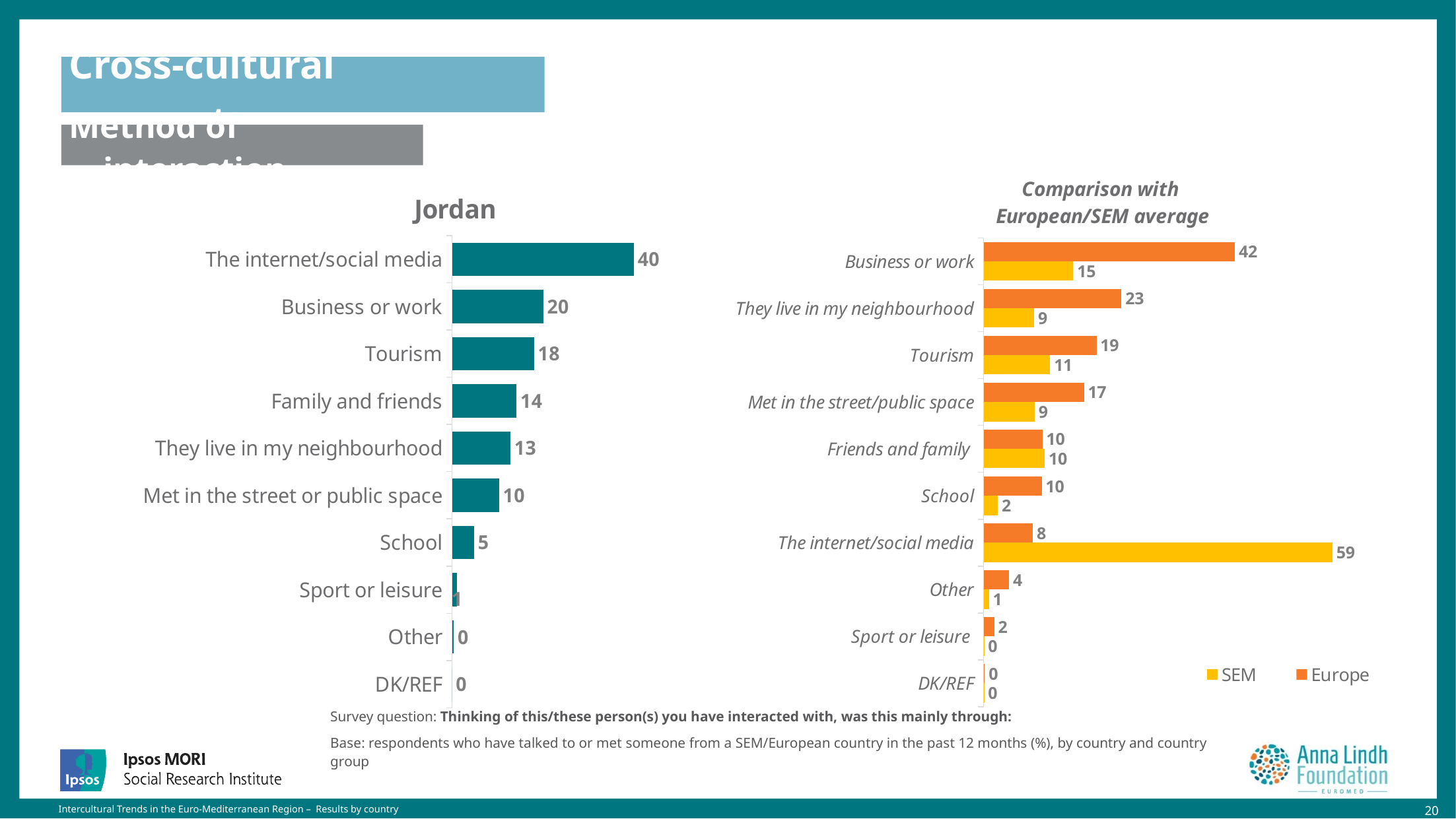
In the Comparison with European/SEM average chart, what is the SEM value for The internet/social media? 59 In the Comparison with European/SEM average chart, which colour represents SEM? Yellow In the Comparison with European/SEM average chart, which is larger for Tourism: SEM or Europe? Europe In the Comparison with European/SEM average chart, how many series does the legend list? 2 In the Comparison with European/SEM average chart, what is the difference between the Europe and SEM values for They live in my neighbourhood? 14 What type of chart is the Jordan chart? Bar chart In the Jordan chart, what is the difference between Business or work and Family and friends? 6 In the Jordan chart, which category has the highest value? The internet/social media In the Jordan chart, what is the value for School? 5 In the Jordan chart, what is the value for Tourism? 18 In the Jordan chart, how many categories are shown? 10 In the Comparison with European/SEM average chart, what is the Europe value for Business or work? 42